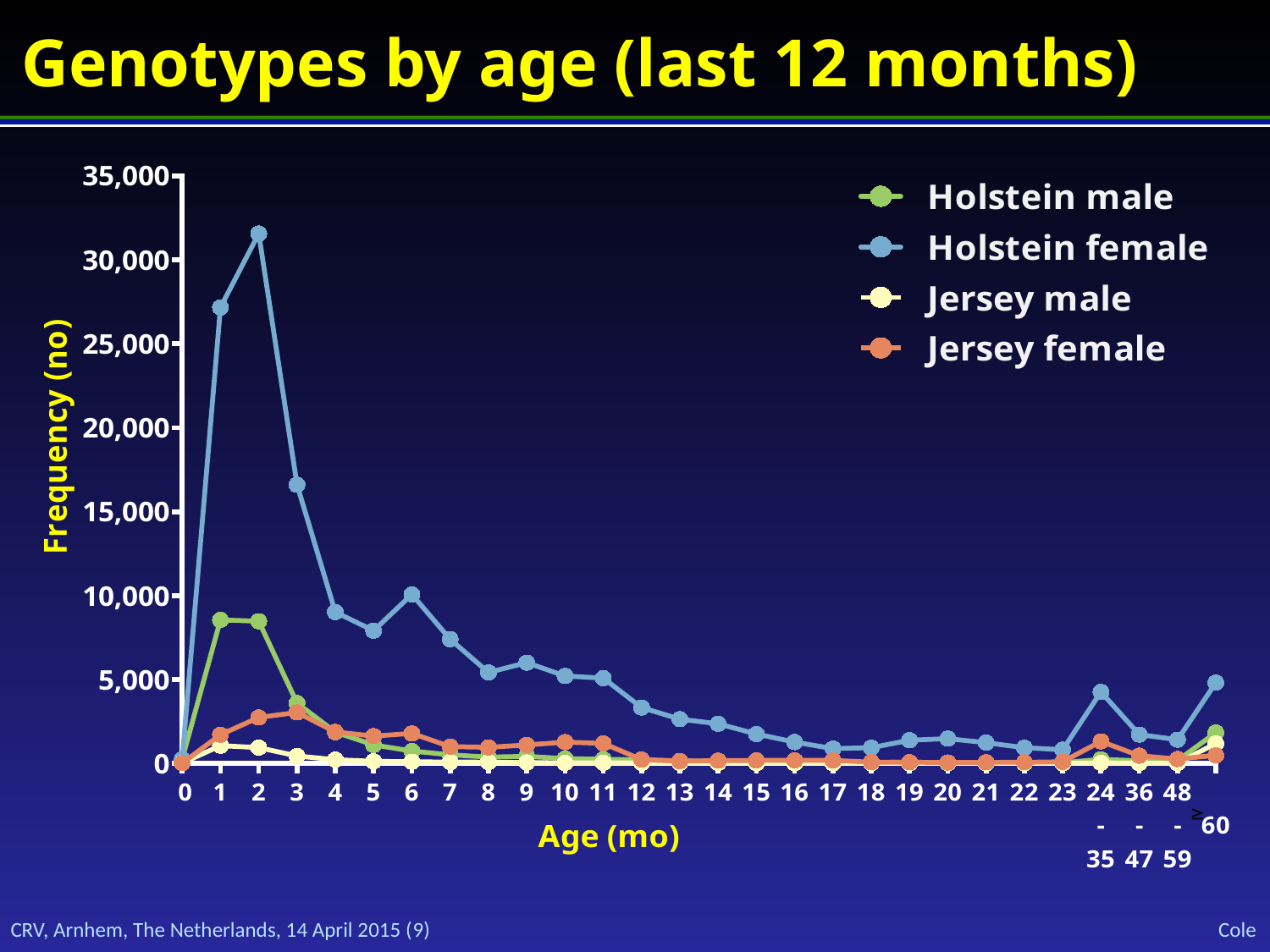
What is the title of the chart? Genotypes by age (last 12 months) Does the Holstein female series rise or fall from age 2 to age 12? fall At which age (mo) does the Holstein female series reach its peak? 2 At age 2, which is larger: Holstein female or Holstein male? Holstein female Is the value for Holstein female at age 1 greater or less than 25,000? greater Is the value for Holstein female at age 2 greater or less than 30,000? greater Is the value for Holstein female at age 3 greater or less than 15,000? greater How many series does the legend list? 4 What is the label of the y axis? Frequency (no) Which series reaches the highest value on the chart? Holstein female What kind of chart is shown on the slide? line chart